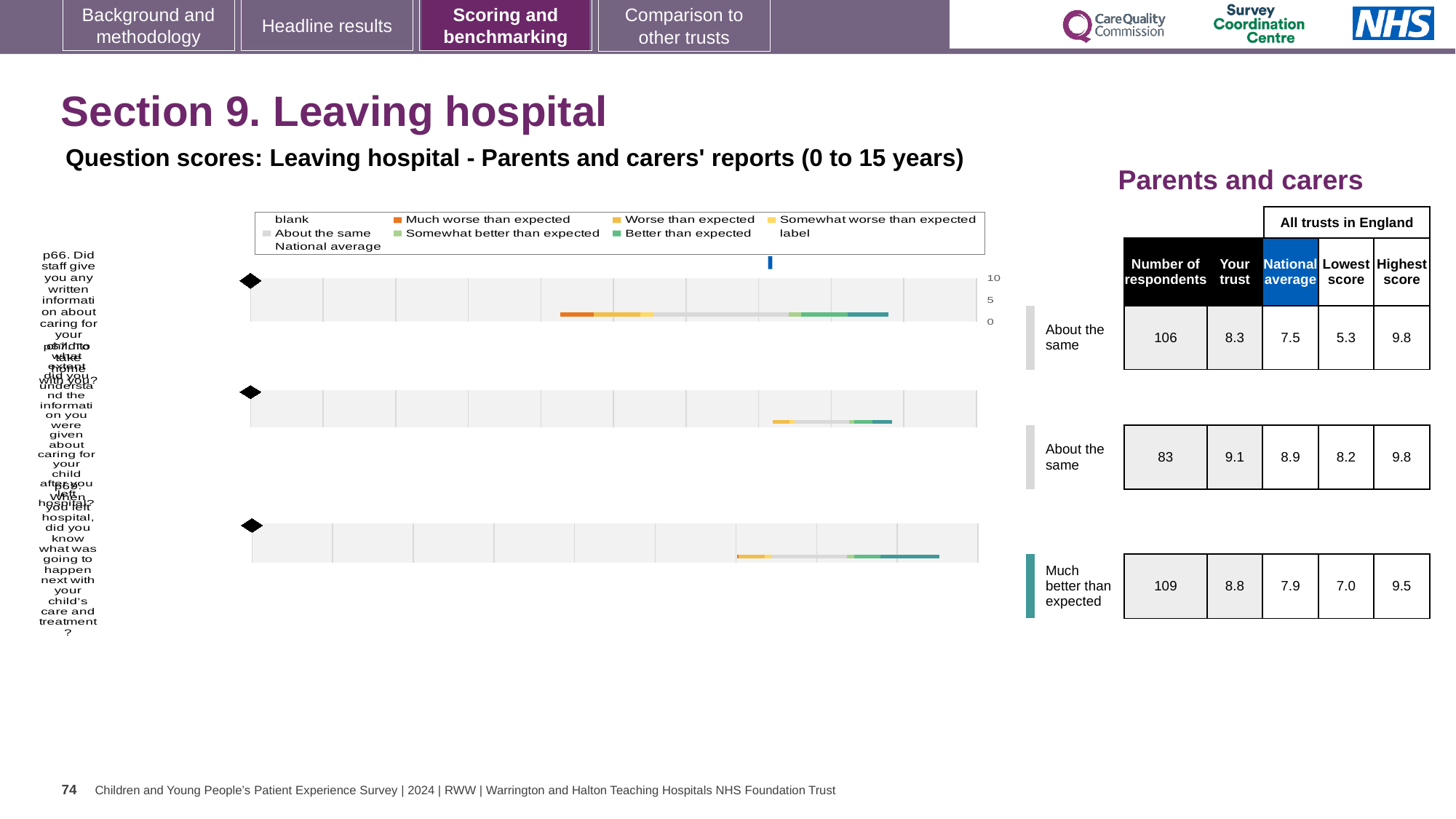
What is the highest value shown on the axis of the first chart? 10 In the table beside the third chart, what is the highest score across all trusts in England? 9.5 What is the difference between the 'Your trust' score and the national average for the first chart? 0.8 In the table beside the second chart, what is the national average score? 8.9 Which legend entry is shown in orange? Much worse than expected Which of the three charts has the highest 'Your trust' score in the table? the second chart (9.1) Is the 'Your trust' score for the third chart larger than its national average? Yes In the table beside the first chart, what is the 'Your trust' score? 8.3 How many respondents are listed for the second chart? 83 How many separate question charts are shown on the slide? 3 What kind of chart is used to show the question scores on this slide? bar chart What benchmark category is given for the third chart? Much better than expected